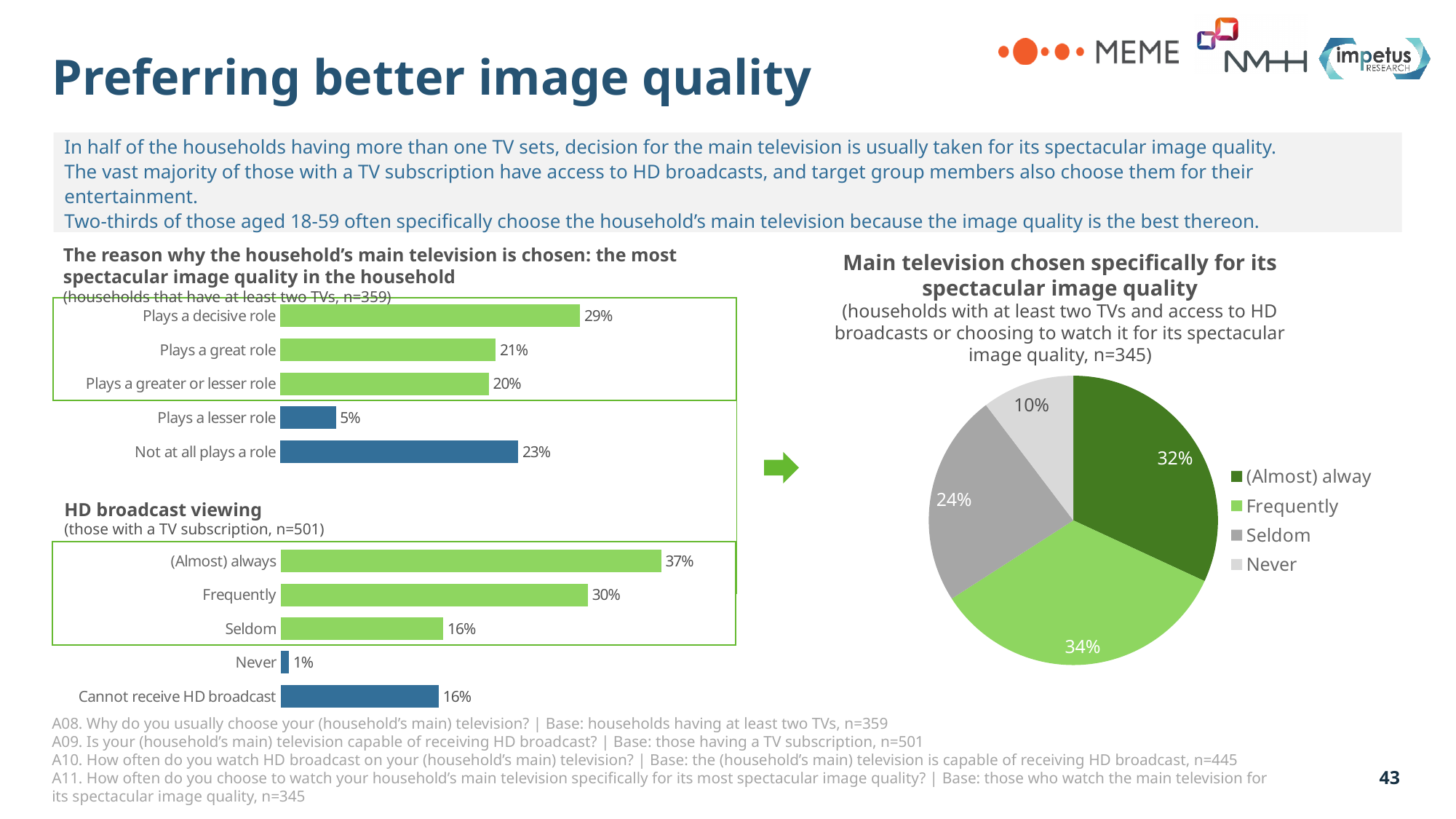
In the 'HD broadcast viewing' bar chart, which is larger: 'Seldom' or 'Never'? Seldom In the 'The reason why the household's main television is chosen' bar chart, which category has the lowest value? Plays a lesser role In the 'HD broadcast viewing' bar chart, what is the value for 'Frequently'? 30% In the 'HD broadcast viewing' bar chart, what is the difference between '(Almost) always' and 'Cannot receive HD broadcast'? 21% In the 'Main television chosen specifically for its spectacular image quality' pie chart, which slice is the largest? Frequently What kind of chart is 'Main television chosen specifically for its spectacular image quality'? Pie chart How many entries does the legend of the 'Main television chosen specifically for its spectacular image quality' pie chart list? 4 In the 'Main television chosen specifically for its spectacular image quality' pie chart, what share does 'Seldom' have? 24% In the 'HD broadcast viewing' bar chart, which category has the highest value? (Almost) always In the 'The reason why the household's main television is chosen' bar chart, what is the difference between 'Not at all plays a role' and 'Plays a lesser role'? 18% In the 'The reason why the household's main television is chosen' bar chart, how many categories are shown? 5 In the 'The reason why the household's main television is chosen' bar chart, what is the value for 'Plays a decisive role'? 29%